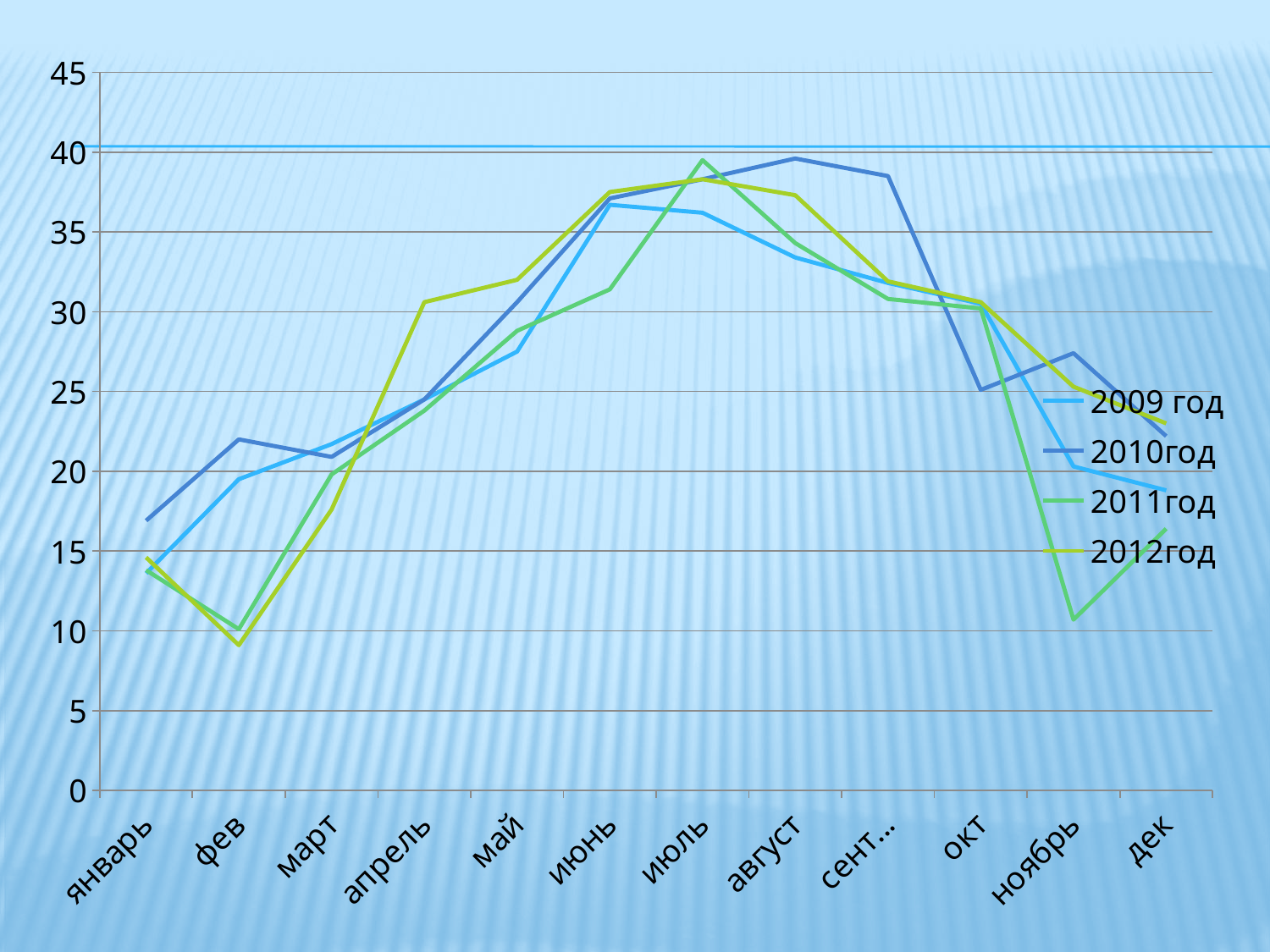
How many months are shown along the x axis? 12 How many series does the legend list? 4 Is the value for 2011год in ноябрь greater or less than 15? less Is the value for 2010год in август greater or less than 35? greater In апрель, which series has the larger value, 2012год or 2009 год? 2012год What kind of chart is shown on the slide? line chart In ноябрь, which series has the larger value, 2010год or 2011год? 2010год Is the value for 2012год in фев greater or less than 10? less In which month does the 2012год series reach its lowest value? фев Does the 2009 год series rise or fall from январь to июнь? rise In which month does the 2011год series reach its highest value? июль